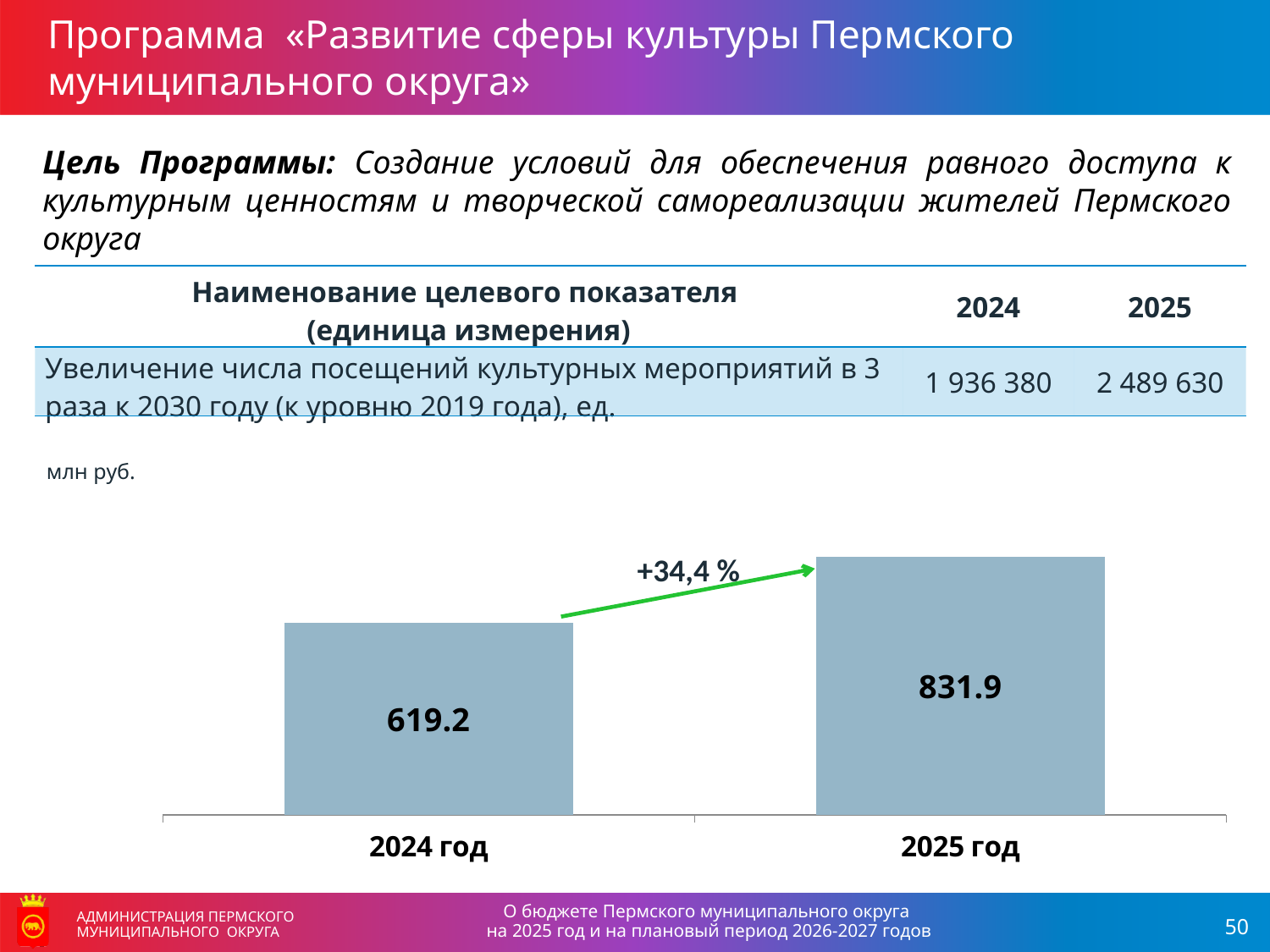
How many bars are shown in the chart? 2 What unit of measurement is indicated above the chart? млн руб. Is the value for 2024 год larger or smaller than the value for 2025 год? smaller What percentage change is labelled on the arrow between the two bars? +34,4 % Which year has the higher value in the bar chart? 2025 год What is the value for 2025 год in the bar chart? 831.9 What is the sum of the two bar values in the chart? 1451.1 Which year has the lower value in the bar chart? 2024 год What is the value for 2024 год in the bar chart? 619.2 What is the difference between the 2025 год and 2024 год values in the bar chart? 212.7 What type of chart is shown on the slide? bar chart Do the values rise or fall from 2024 год to 2025 год? rise